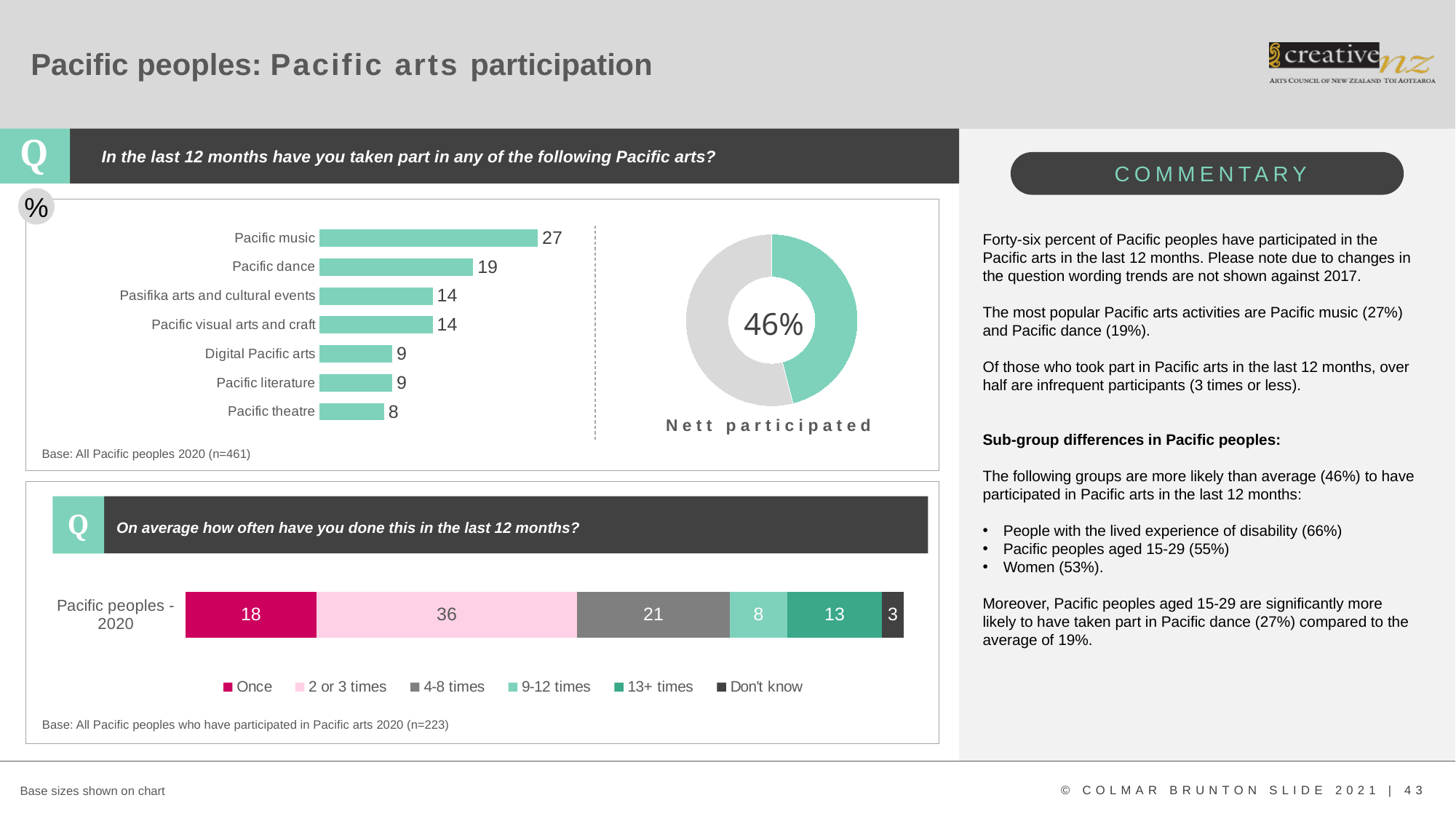
In the stacked bar chart about how often people have done this, what is the value for 2 or 3 times? 36 In the bar chart of Pacific arts activities, which is larger: Digital Pacific arts or Pacific theatre? Digital Pacific arts In the stacked bar chart about how often people have done this, what is the difference between the 4-8 times and 13+ times values? 8 In the bar chart of Pacific arts activities, which activity has the highest value? Pacific music In the bar chart of Pacific arts activities, how many activities are listed? 7 In the bar chart of Pacific arts activities, what is the value for Pacific dance? 19 In the donut chart labelled Nett participated, what percentage is shown? 46% In the bar chart of Pacific arts activities, which activity has the lowest value? Pacific theatre What type of chart is used to show the Pacific arts activities in the top panel? Bar chart In the bar chart of Pacific arts activities, what is the difference between Pacific music and Pacific dance? 8 In the bar chart of Pacific arts activities, what is the value for Pacific music? 27 In the stacked bar chart about how often people have done this, how many series does the legend list? 6